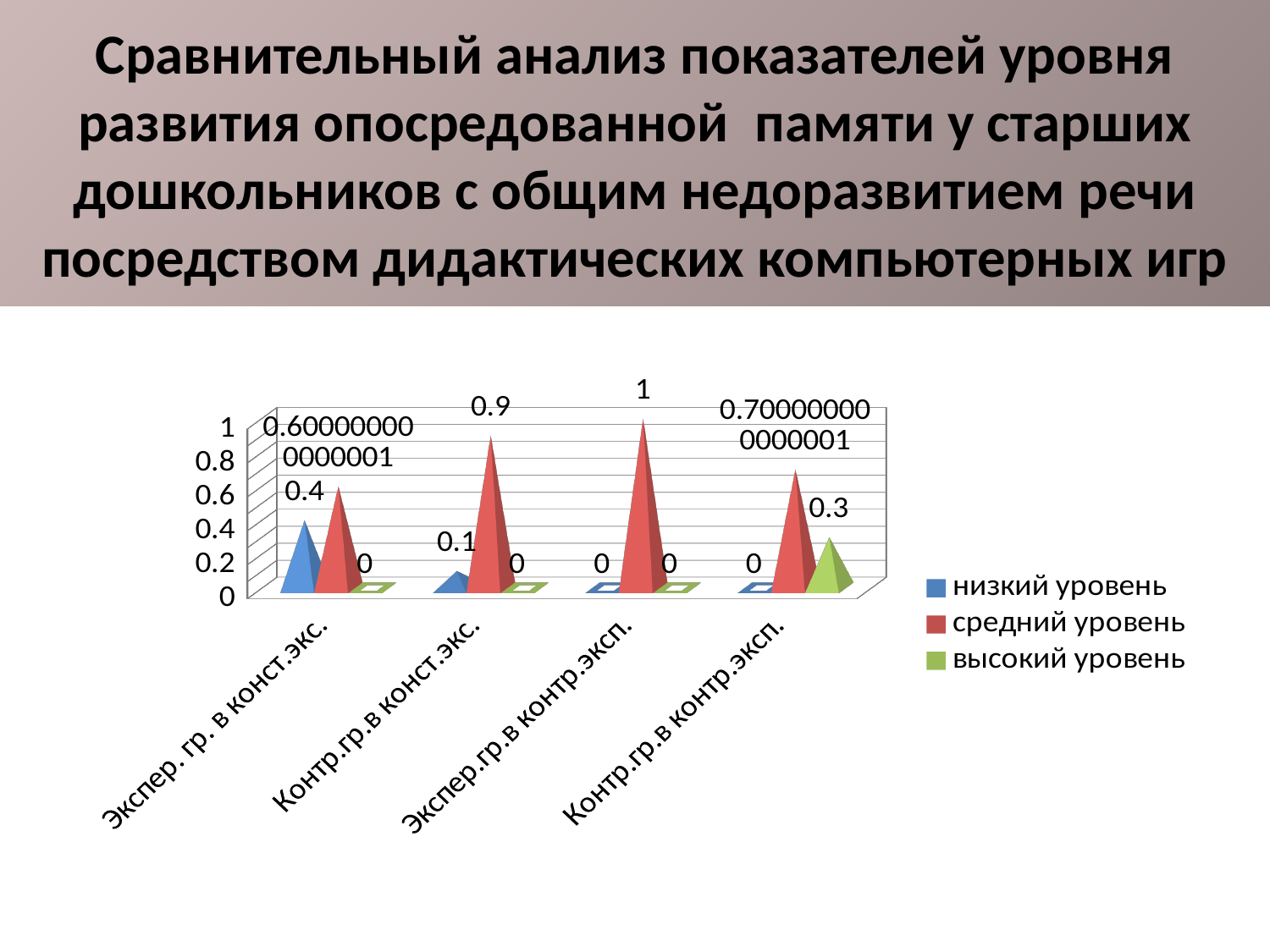
What kind of chart is shown on the slide? bar chart What is the value of средний уровень for Экспер.гр.в контр.эксп.? 1 Which category has the highest value for средний уровень? Экспер.гр.в контр.эксп. How many categories are shown on the x axis? 4 What is the difference between средний уровень for Контр.гр.в конст.экс. and низкий уровень for Контр.гр.в конст.экс.? 0.8 Which is larger: низкий уровень for Экспер. гр. в конст.экс. or высокий уровень for Контр.гр.в контр.эксп.? низкий уровень for Экспер. гр. в конст.экс. What is the value of средний уровень for Контр.гр.в конст.экс.? 0.9 How many series does the legend list? 3 What is the value of низкий уровень for Экспер. гр. в конст.экс.? 0.4 Which category has the highest value for низкий уровень? Экспер. гр. в конст.экс. What is the value of низкий уровень for Контр.гр.в конст.экс.? 0.1 What is the value of высокий уровень for Контр.гр.в контр.эксп.? 0.3